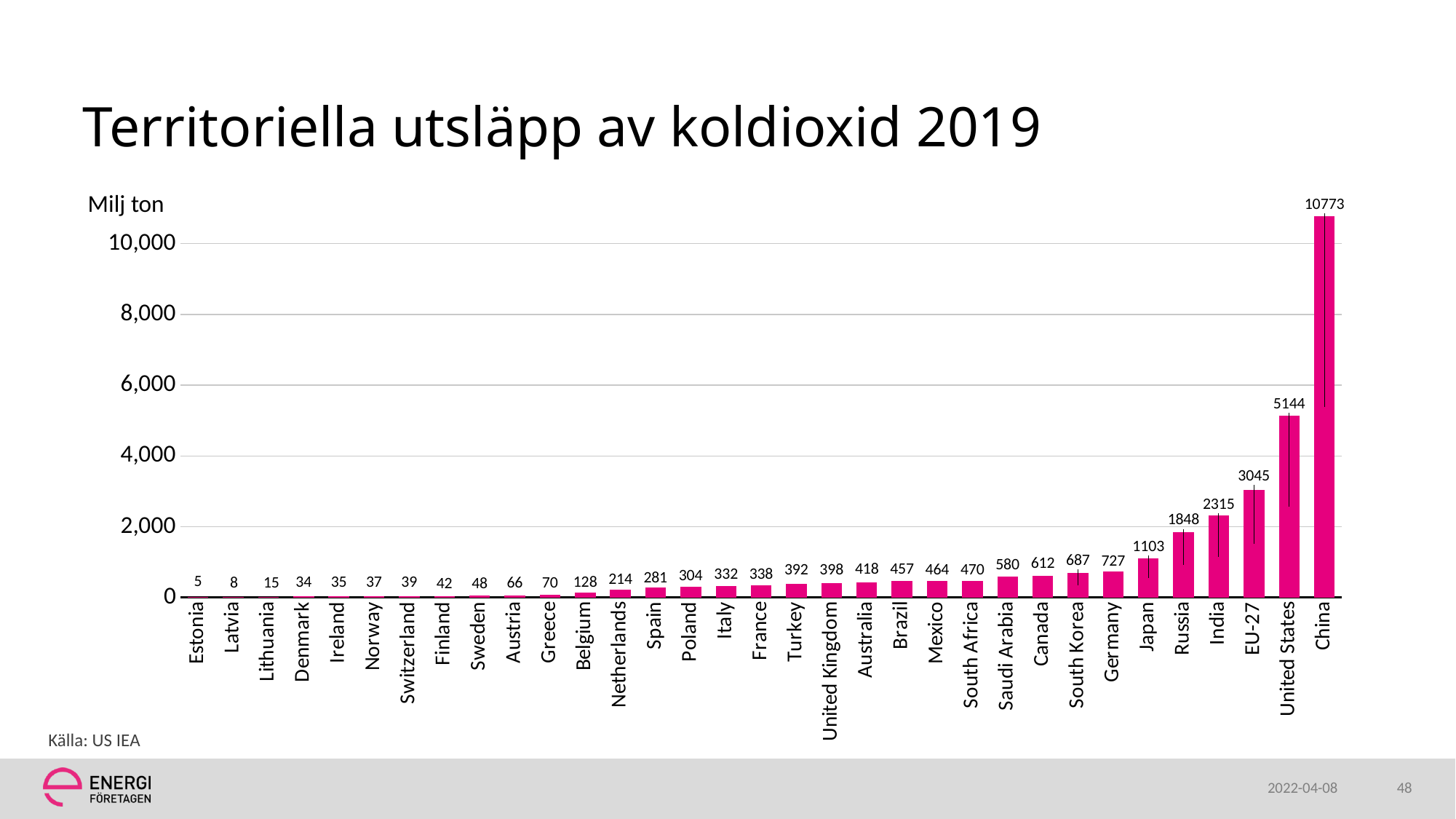
Which country has the lowest value? Estonia Is the value for EU-27 greater or less than 2,000? greater What is the difference between the values for Germany and Japan? 376 What kind of chart is shown on the slide? Bar chart What is the title of the chart? Territoriella utsläpp av koldioxid 2019 Which is larger, the value for India or the value for Russia? India What is the value for Germany? 727 What is the value for China? 10773 How many countries or regions are shown on the x axis? 33 Which country has the highest value? China What is the value for Sweden? 48 What is the difference between the values for China and the United States? 5629